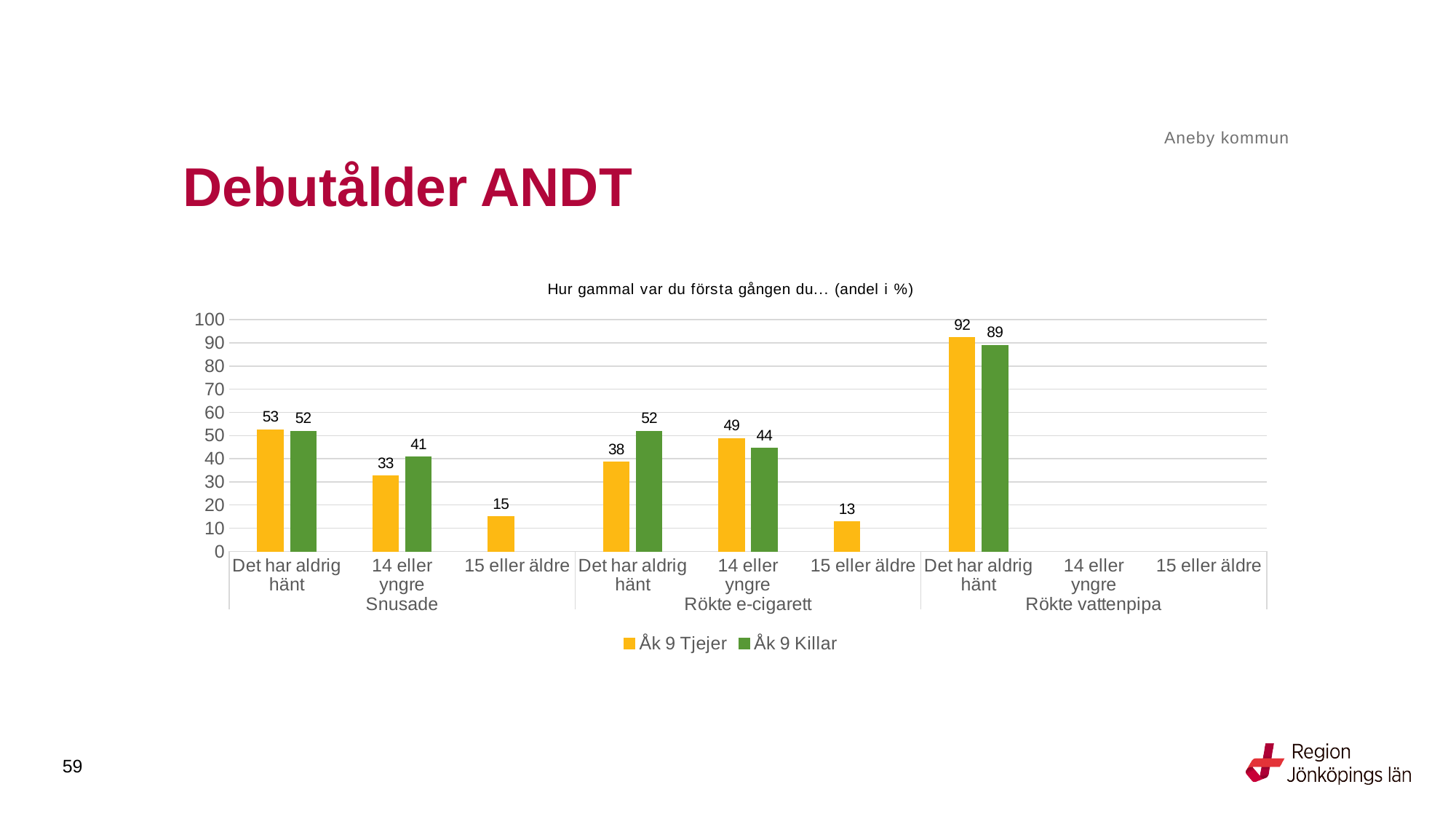
What kind of chart is shown on the slide? Bar chart What is the difference between Åk 9 Killar and Åk 9 Tjejer for 'Det har aldrig hänt' under Rökte e-cigarett? 14 What is the value for Åk 9 Killar for '14 eller yngre' under Snusade? 41 How many series does the legend list? 2 What is the value for Åk 9 Tjejer for '15 eller äldre' under Rökte e-cigarett? 13 What is the difference between Åk 9 Tjejer and Åk 9 Killar for 'Det har aldrig hänt' under Rökte vattenpipa? 3 What is the value for Åk 9 Tjejer for 'Det har aldrig hänt' under Snusade? 53 Which bar has the highest value in the chart? Åk 9 Tjejer, Det har aldrig hänt, Rökte vattenpipa (92) For '14 eller yngre' under Rökte e-cigarett, which is larger: Åk 9 Tjejer or Åk 9 Killar? Åk 9 Tjejer What is the value for Åk 9 Tjejer for 'Det har aldrig hänt' under Rökte e-cigarett? 38 What is the title of the chart? Hur gammal var du första gången du… (andel i %) What is the value for Åk 9 Killar for 'Det har aldrig hänt' under Rökte vattenpipa? 89